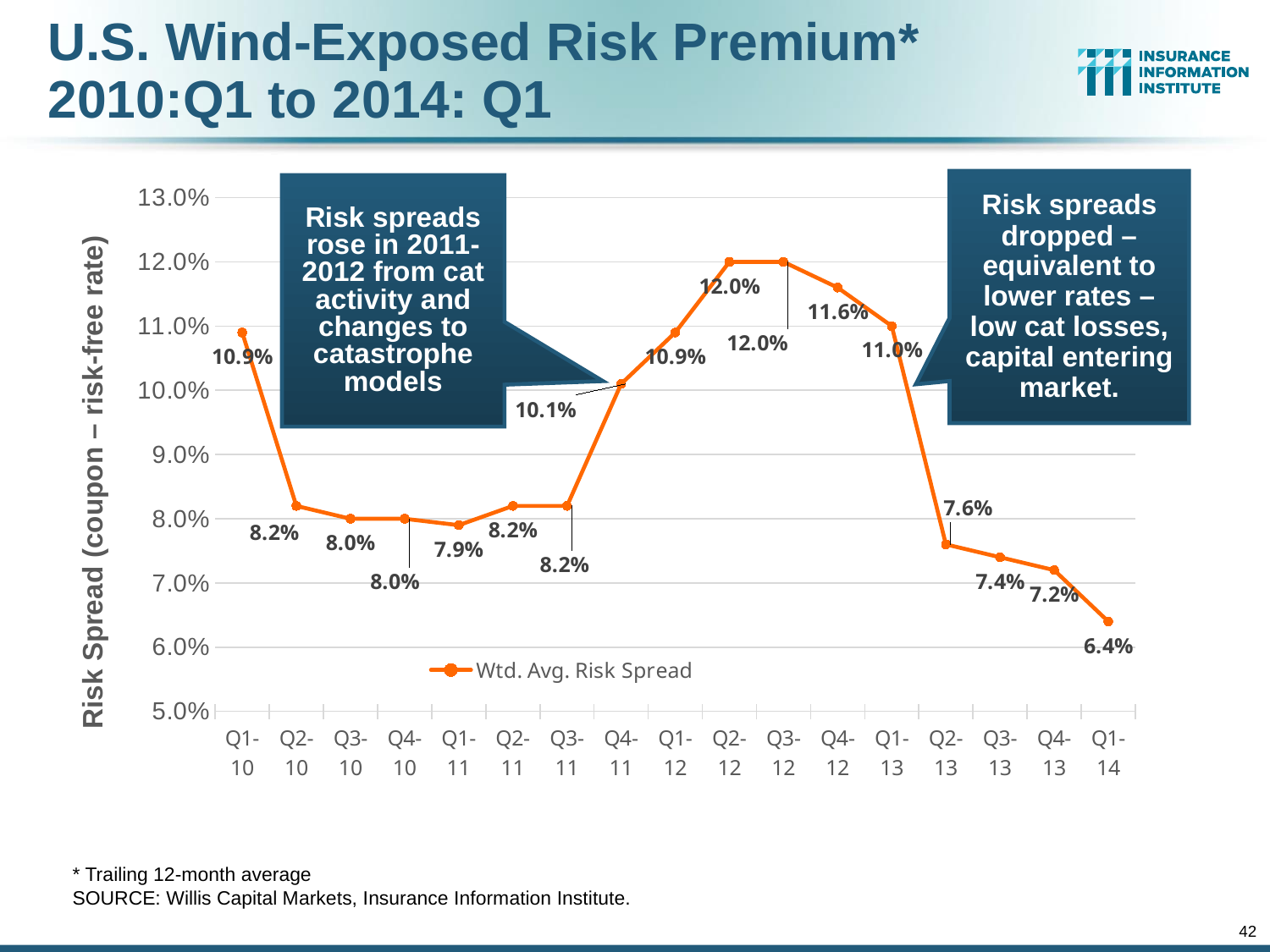
Which quarter has the lowest weighted average risk spread? Q1-14 What is the weighted average risk spread for Q1-14? 6.4% What is the highest weighted average risk spread value shown on the chart? 12.0% Which quarter has a larger risk spread, Q4-12 or Q1-13? Q4-12 Does the risk spread rise or fall from Q1-13 to Q1-14? Fall How many quarters are plotted on the chart? 17 What is the weighted average risk spread for Q4-11? 10.1% What kind of chart is shown on the slide? Line chart What is the weighted average risk spread for Q2-12? 12.0% What is the weighted average risk spread for Q1-11? 7.9% By how many percentage points did the risk spread fall from Q1-13 to Q2-13? 3.4 percentage points How many series does the legend list? 1